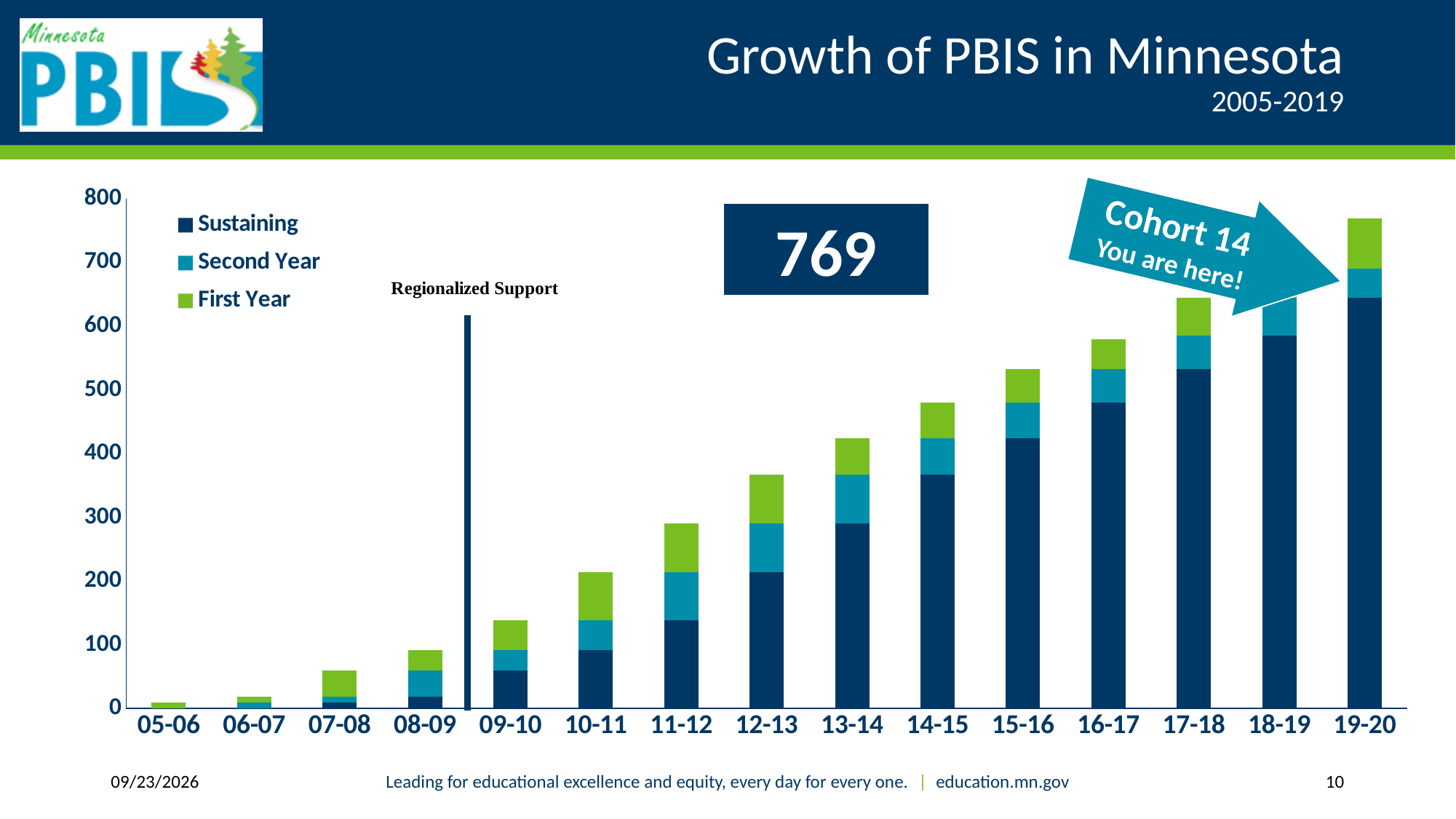
How many school-year categories are shown on the x axis? 15 What number is displayed in the dark box above the chart? 769 What kind of chart is shown on the slide? bar chart How many series does the chart legend list? 3 Do the stacked bar totals rise or fall from 05-06 to 19-20? rise Which school year has the shortest stacked bar? 05-06 What are the three series named in the chart legend? Sustaining, Second Year, First Year Is the total stacked bar for 19-20 greater or less than 700? greater Is the Sustaining segment for 19-20 greater or less than 600? greater Which has the larger total stacked bar, 17-18 or 12-13? 17-18 Which school year has the tallest stacked bar? 19-20